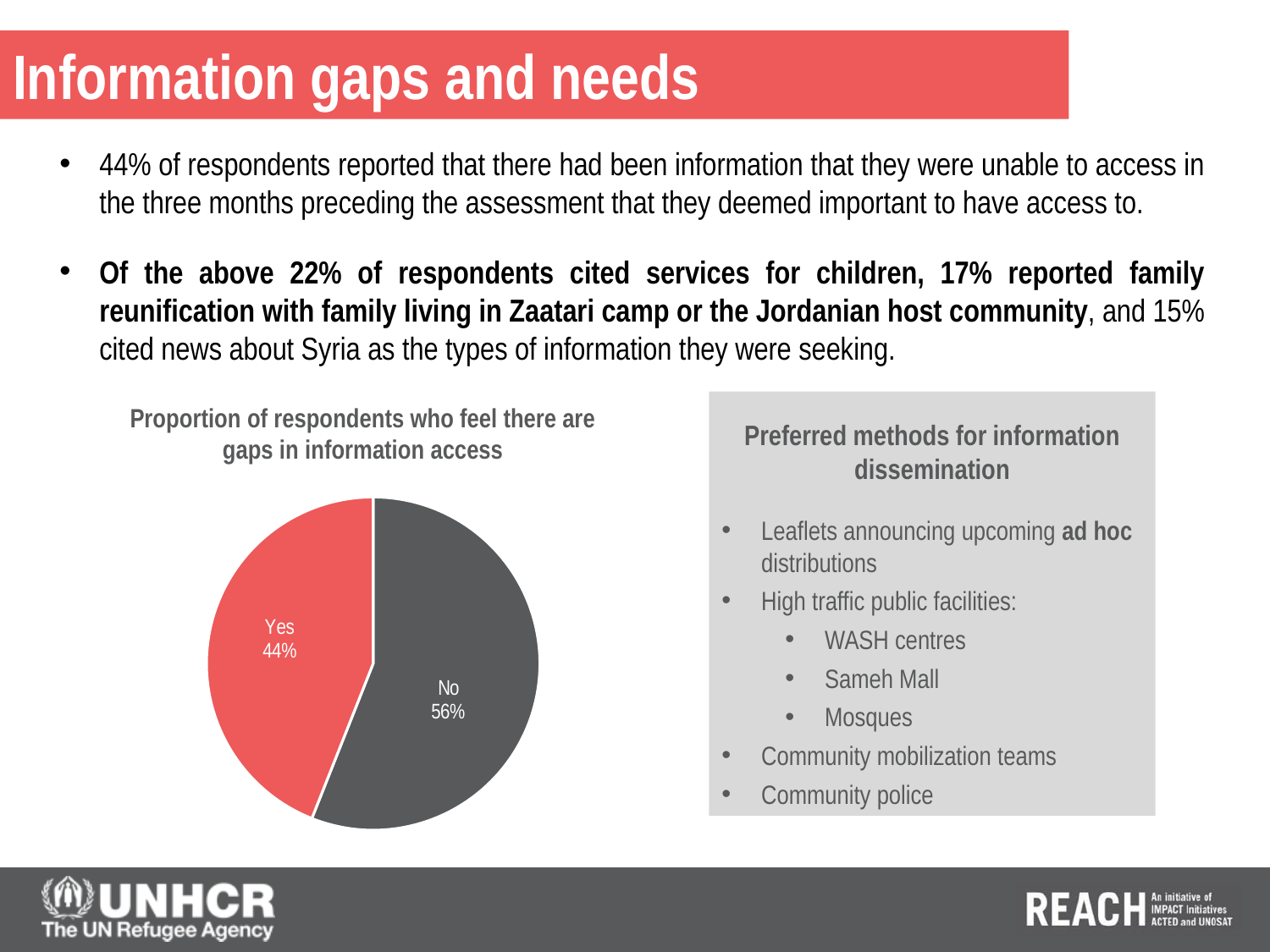
Which is larger in the pie chart, the "Yes" slice or the "No" slice? No What is the total of the two slices in the pie chart? 100% How many slices does the pie chart have? 2 What kind of chart is shown on the slide? Pie chart What share of respondents answered "Yes" in the pie chart? 44% What colour is the "Yes" slice in the pie chart? Red What is the title of the pie chart? Proportion of respondents who feel there are gaps in information access What share of respondents answered "No" in the pie chart? 56% Which slice of the pie chart is the smallest? Yes What is the difference in percentage points between the "No" and "Yes" slices? 12 Which slice of the pie chart is the largest? No Is the share for "No" greater or less than 50%? greater